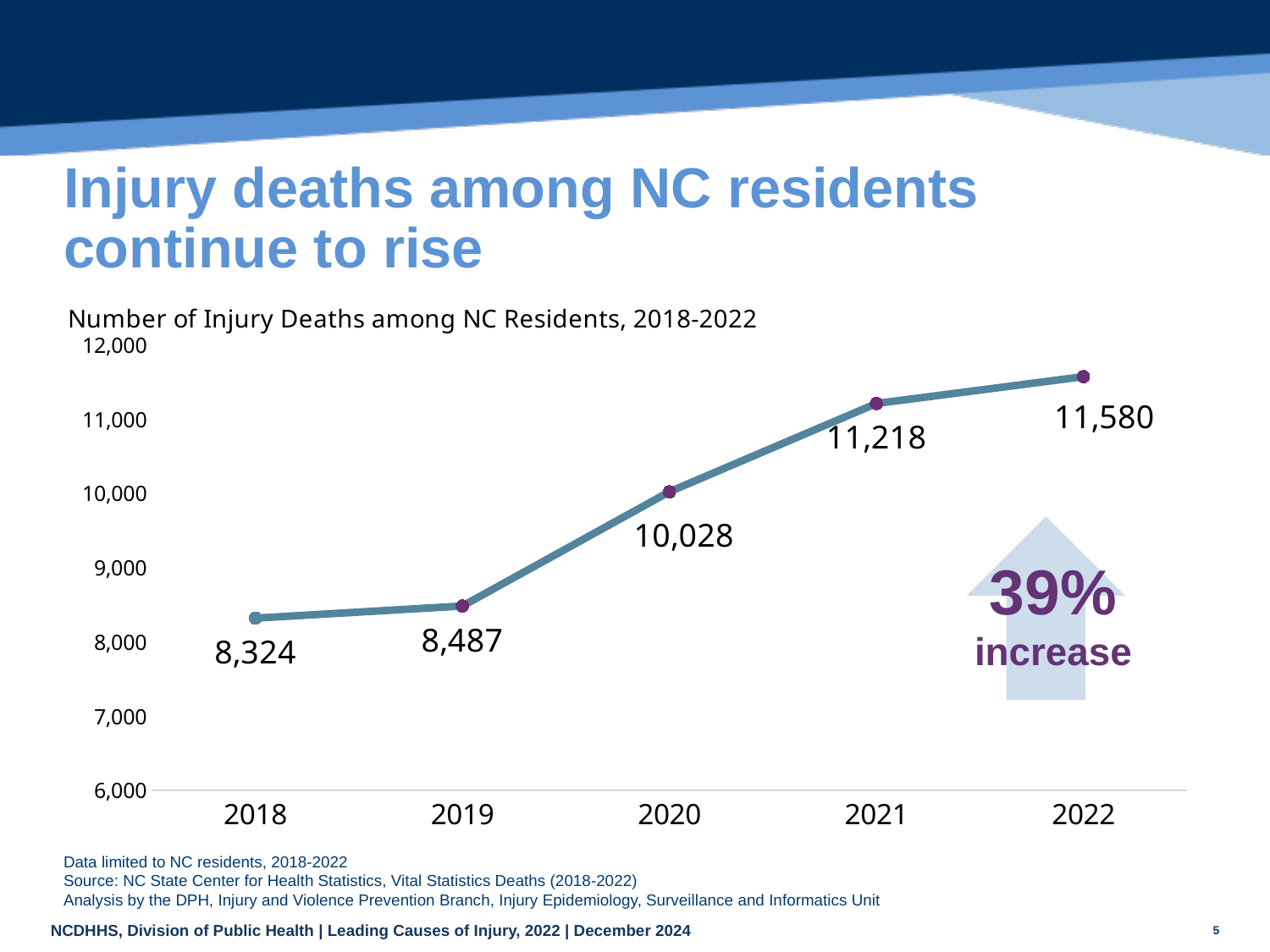
Is the value for 2020 greater or less than 9,000? greater What is the difference in injury deaths between 2022 and 2018? 3,256 Which year has the highest number of injury deaths? 2022 Which year had more injury deaths, 2019 or 2021? 2021 What is the number of injury deaths among NC residents in 2022? 11,580 What is the number of injury deaths among NC residents in 2018? 8,324 How many years are plotted on the chart? 5 What is the difference in injury deaths between 2021 and 2020? 1,190 What kind of chart is shown on the slide? Line chart What is the number of injury deaths among NC residents in 2020? 10,028 Which year has the lowest number of injury deaths? 2018 Do injury deaths rise or fall from 2018 to 2022? Rise